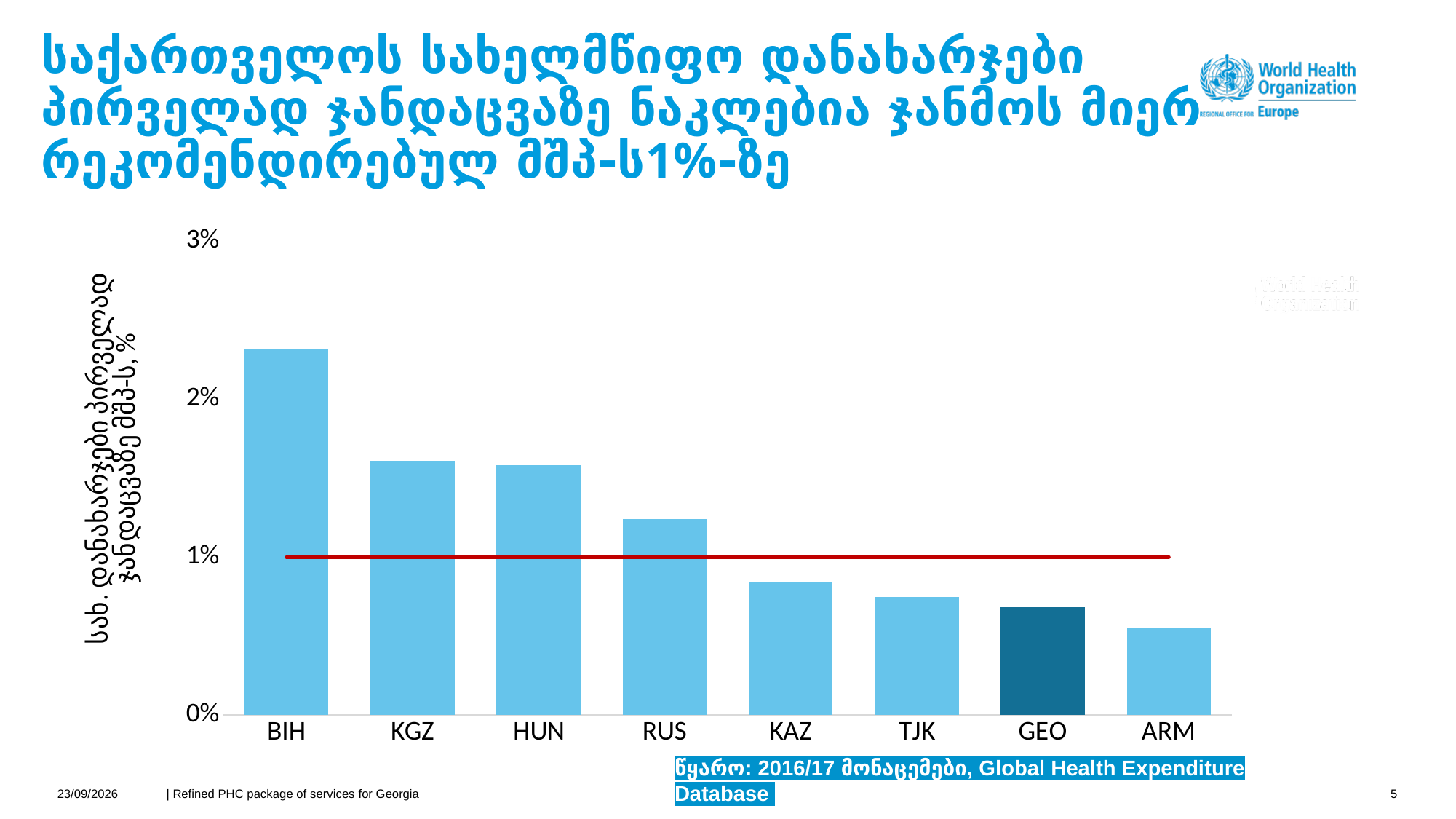
Which is larger, the value for GEO or the value for ARM? GEO Is the value for BIH greater or less than 2%? greater Which is larger, the value for RUS or the value for TJK? RUS Which country has the lowest bar in the chart? ARM Do the bar values rise or fall from left to right along the x axis? fall Is the value for KAZ greater or less than 1%? less Is the value for GEO greater or less than 1%? less Which country has the highest bar in the chart? BIH Which country's bar is shown in a darker blue than the others? GEO How many countries are shown on the x axis of the chart? 8 What kind of chart is shown on the slide? bar chart